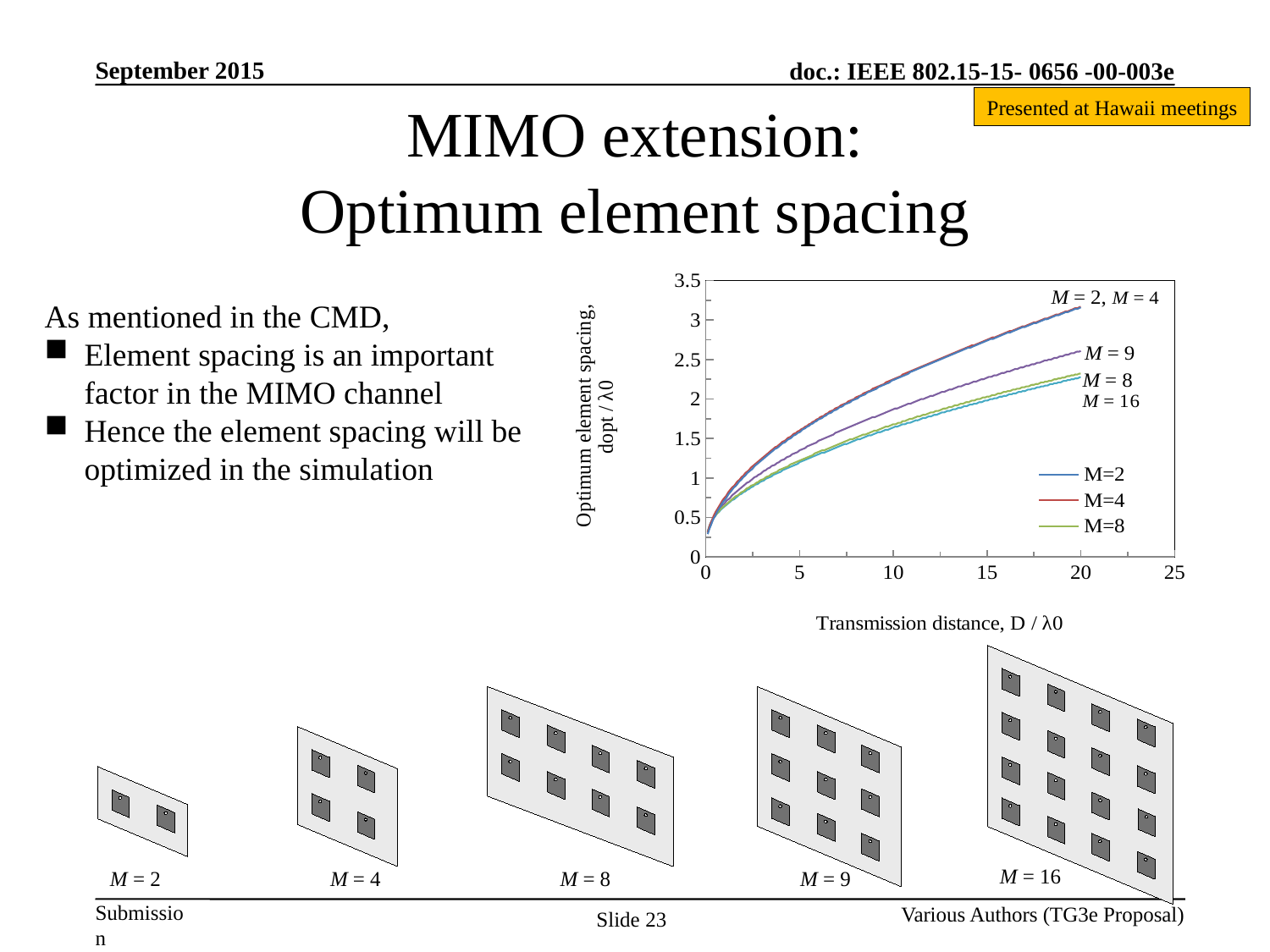
Is the value of the M=2 curve at a transmission distance of 20 greater or less than 3? greater Is the value of the M=2 curve at a transmission distance of 10 greater or less than 2? greater Is the value of the M=8 curve at a transmission distance of 5 greater or less than 1.5? less How many series does the chart legend list? 3 What is the label of the x axis of the chart? Transmission distance, D / λ0 Do the curves rise or fall as the transmission distance increases? rise What colour is the M=4 series in the chart legend? red What kind of chart is shown on the slide? line chart At a transmission distance of 20, which curve has the larger value, M=9 or M=8? M=9 At a transmission distance of 20, which curve has the larger value, M=2 or M=8? M=2